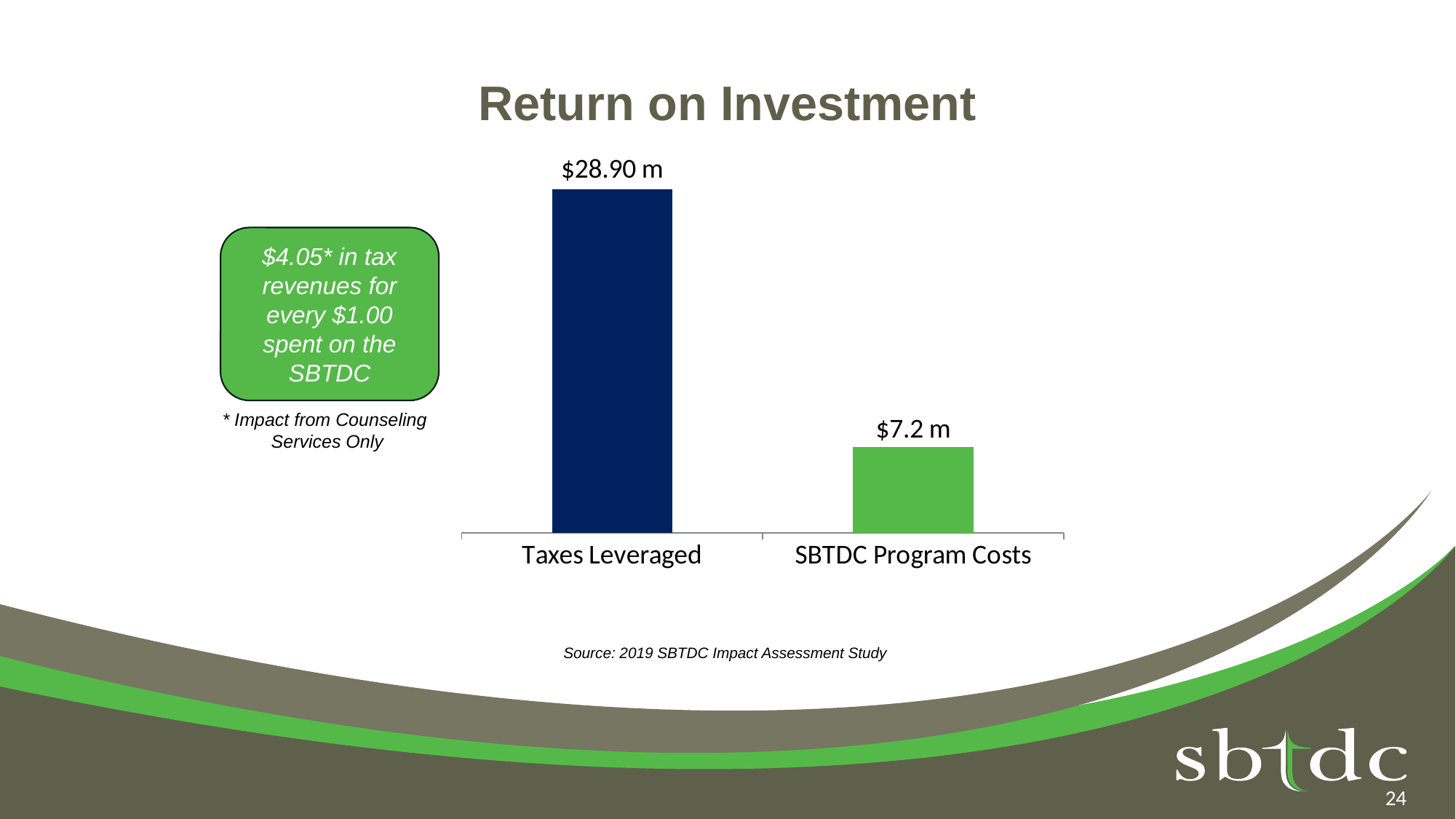
Which category has the highest value? Taxes Leveraged What kind of chart is shown on the slide? Bar chart How many categories are shown in the chart? 2 What colour is the bar for SBTDC Program Costs? Green Which is larger, Taxes Leveraged or SBTDC Program Costs? Taxes Leveraged What is the value for SBTDC Program Costs? $7.2 m What is the value for Taxes Leveraged? $28.90 m What is the title of the slide containing the chart? Return on Investment Which category has the lowest value? SBTDC Program Costs What is the difference between Taxes Leveraged and SBTDC Program Costs? $21.70 m